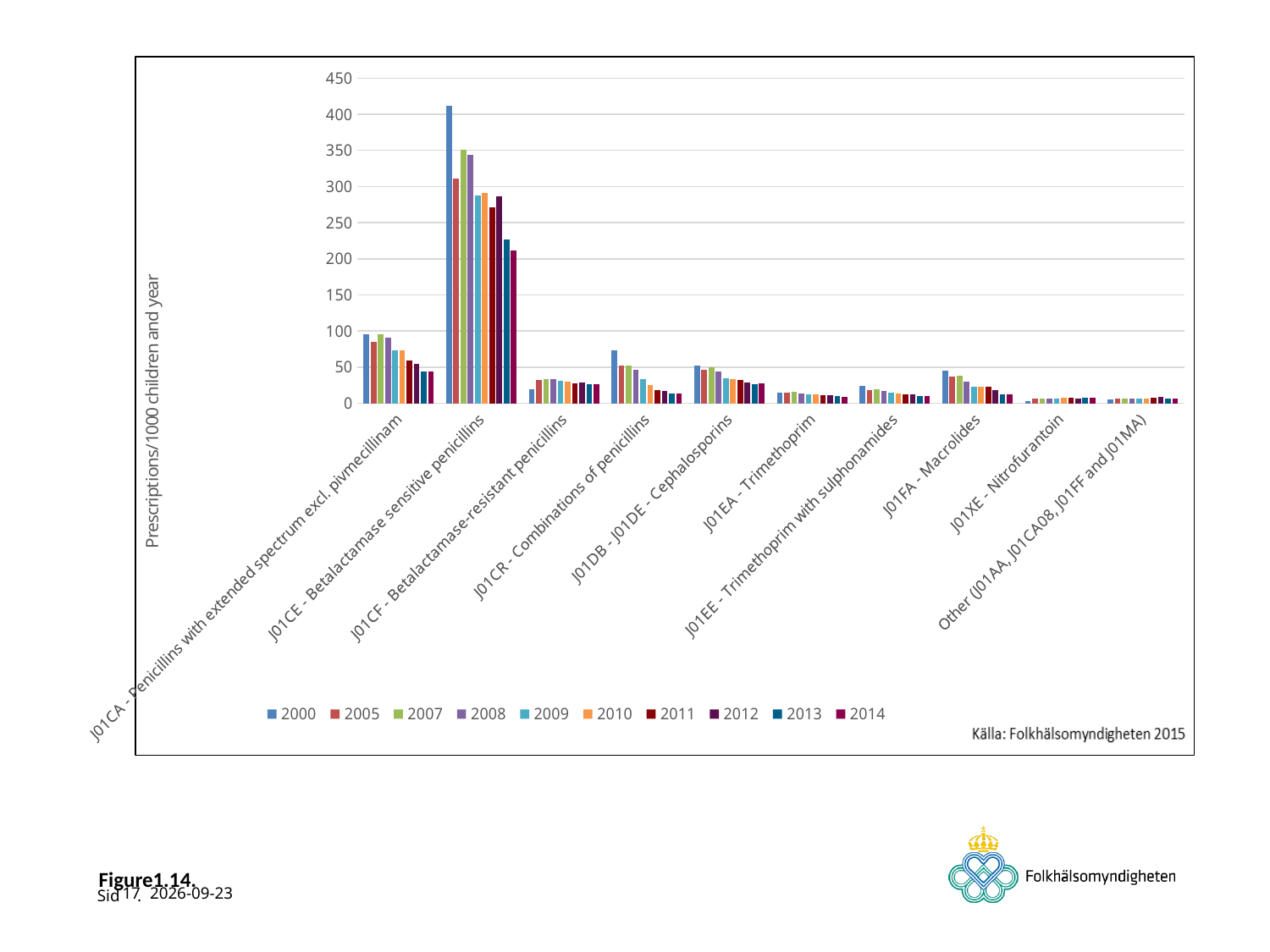
What is the label on the vertical axis? Prescriptions/1000 children and year Is the 2000 value for J01CA - Penicillins with extended spectrum excl. pivmecillinam greater or less than 100? less How many antibiotic categories are shown along the x axis? 10 How many years (series) does the legend list? 10 Is the 2014 value for J01CE - Betalactamase sensitive penicillins greater or less than 250? less Is the 2000 value for J01CR - Combinations of penicillins greater or less than 50? greater Within J01CE - Betalactamase sensitive penicillins, which year has the highest value? 2000 Do the values for J01CE - Betalactamase sensitive penicillins generally rise or fall from 2000 to 2014? fall Which category has the highest bars overall? J01CE - Betalactamase sensitive penicillins Which is larger in 2000: the value for J01CE - Betalactamase sensitive penicillins or for J01FA - Macrolides? J01CE - Betalactamase sensitive penicillins What kind of chart is shown on the slide? bar chart